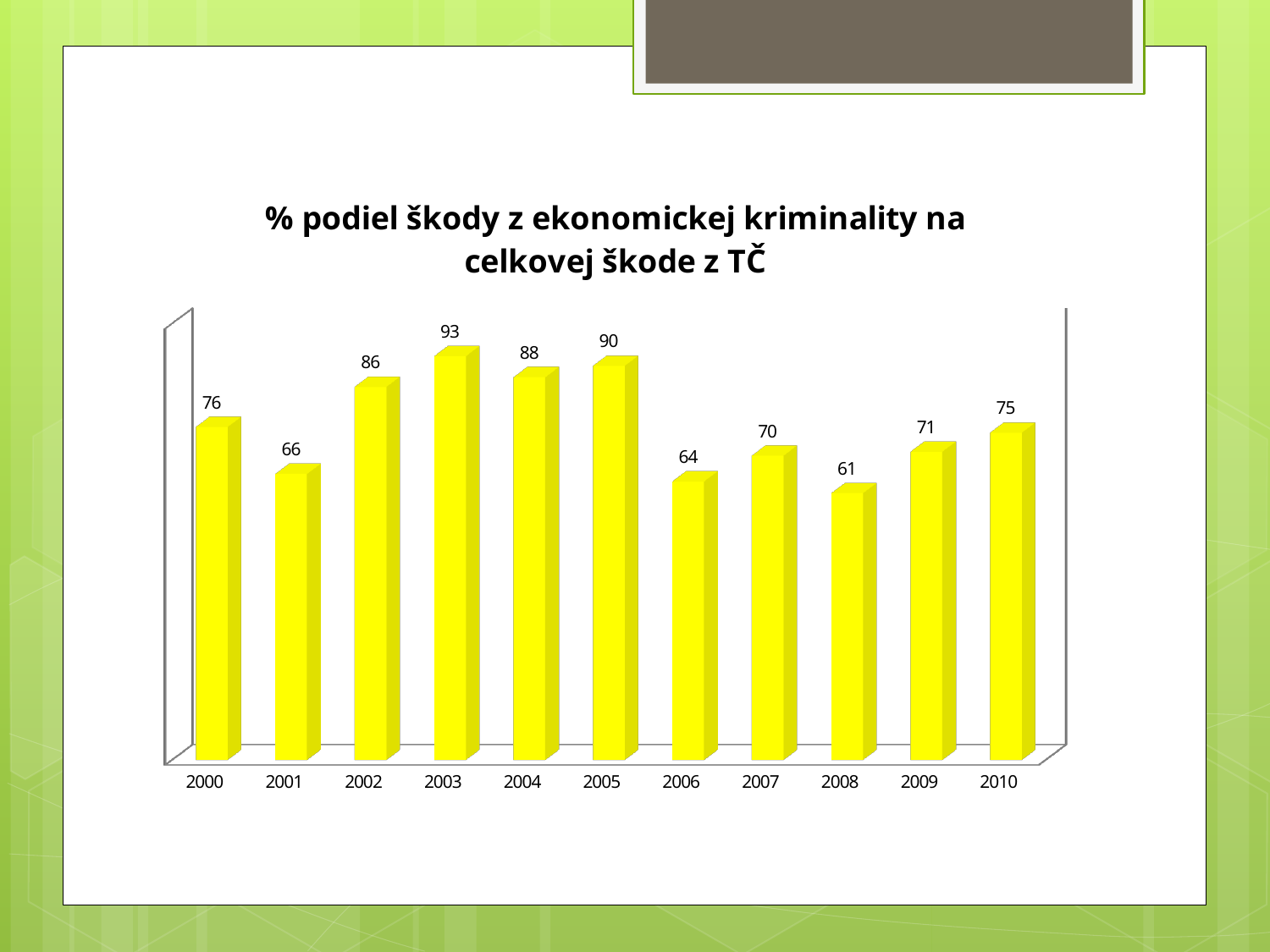
What kind of chart is this? bar chart What is the value for 2008? 61 What is the difference between the values for 2003 and 2008? 32 Do the values rise or fall from 2005 to 2006? fall What is the title of the chart? % podiel škody z ekonomickej kriminality na celkovej škode z TČ Which year has the lowest value? 2008 How many years are shown on the x axis? 11 What is the value for 2003? 93 What is the value for 2010? 75 Which is larger, the value for 2005 or the value for 2004? 2005 What is the difference between the values for 2000 and 2001? 10 Which year has the highest value? 2003